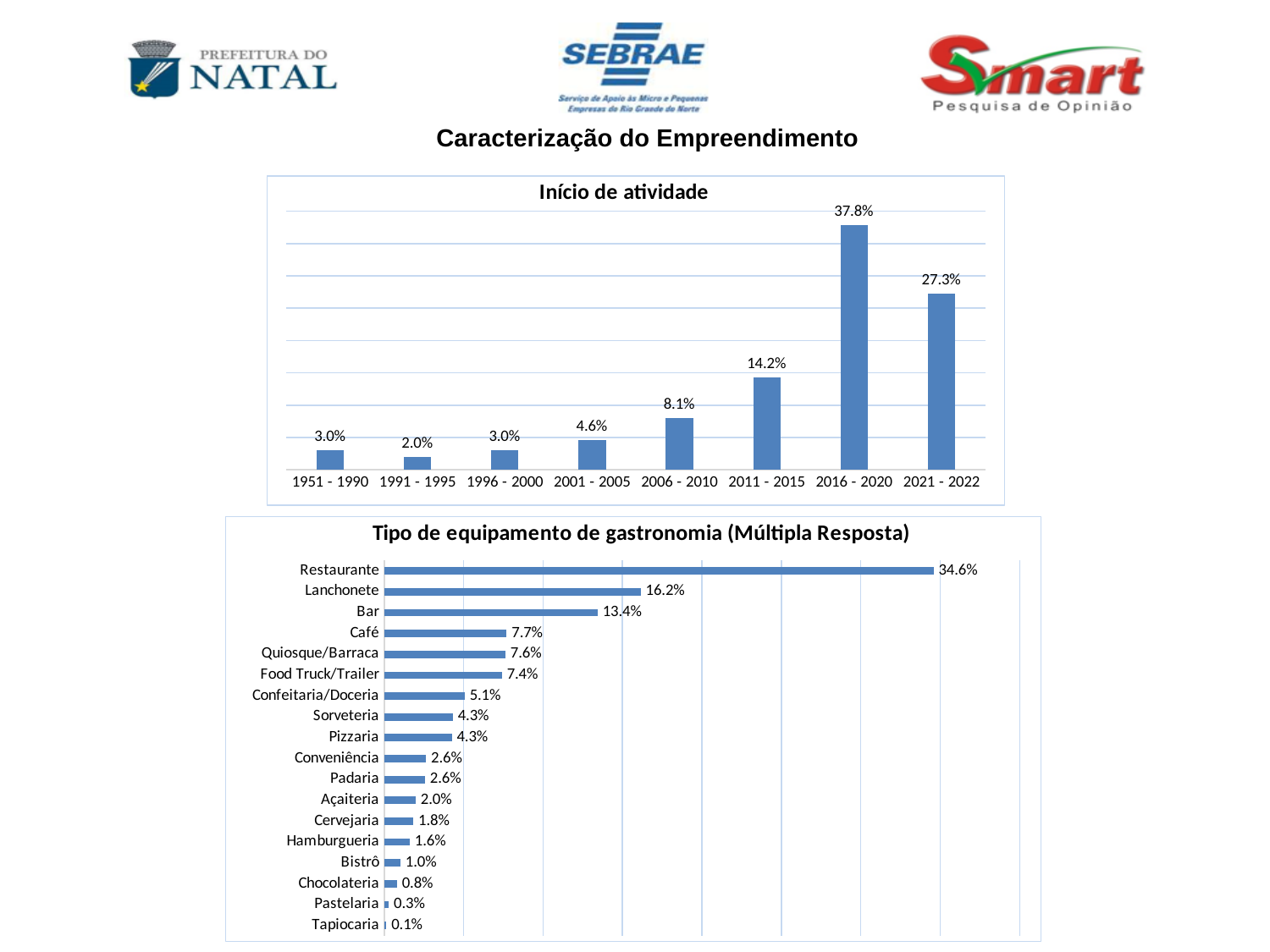
In the 'Tipo de equipamento de gastronomia (Múltipla Resposta)' chart, what is the value for Bar? 13.4% In the 'Início de atividade' chart, what is the value for 2016 - 2020? 37.8% In the 'Tipo de equipamento de gastronomia (Múltipla Resposta)' chart, which category has the highest value? Restaurante In the 'Tipo de equipamento de gastronomia (Múltipla Resposta)' chart, what is the difference between the values for Restaurante and Lanchonete? 18.4% In the 'Início de atividade' chart, how many periods are shown on the x axis? 8 In the 'Tipo de equipamento de gastronomia (Múltipla Resposta)' chart, which category has the lowest value? Tapiocaria What kind of chart is 'Início de atividade'? Bar chart In the 'Início de atividade' chart, what is the difference between the values for 2016 - 2020 and 2021 - 2022? 10.5% In the 'Início de atividade' chart, which is larger: the value for 2006 - 2010 or the value for 2011 - 2015? 2011 - 2015 In the 'Tipo de equipamento de gastronomia (Múltipla Resposta)' chart, what is the value for Food Truck/Trailer? 7.4% In the 'Tipo de equipamento de gastronomia (Múltipla Resposta)' chart, how many categories are listed? 18 In the 'Início de atividade' chart, which period has the lowest value? 1991 - 1995